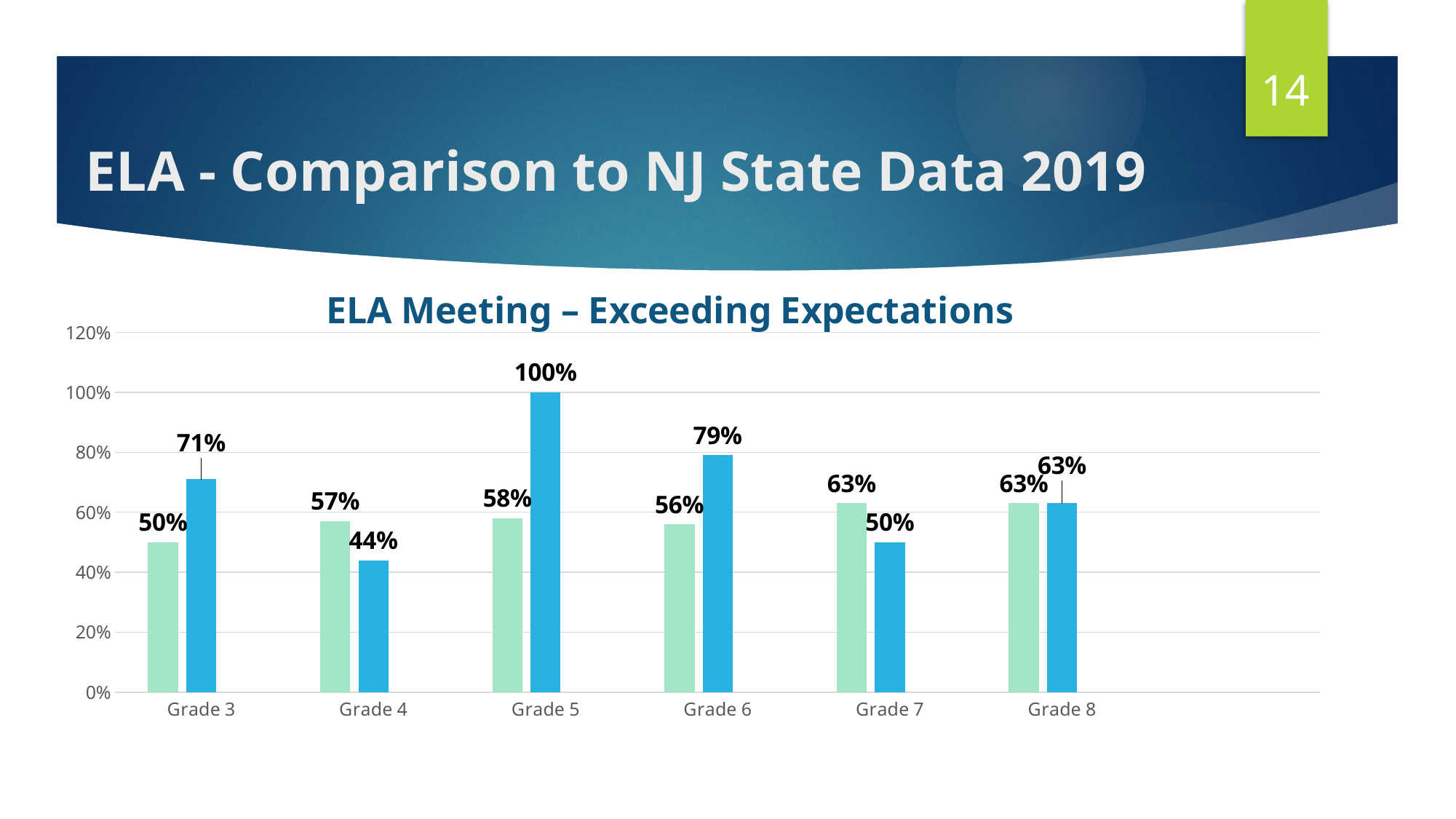
How many grades are shown on the x axis of the chart? 6 What is the difference between the blue bar and the light green bar for Grade 3? 21% What kind of chart is shown on the slide? bar chart For Grade 6, which is larger: the light green bar or the blue bar? the blue bar What is the value of the light green bar for Grade 4? 57% What is the title of the chart on the slide? ELA Meeting – Exceeding Expectations Which grade has the lowest light green bar? Grade 3 What is the value of the blue bar for Grade 7? 50% What is the value of the blue bar for Grade 5 in the ELA Meeting – Exceeding Expectations chart? 100% Which grade has the highest blue bar? Grade 5 What is the difference between the blue bar and the light green bar for Grade 5? 42% Which grade has the lowest blue bar? Grade 4